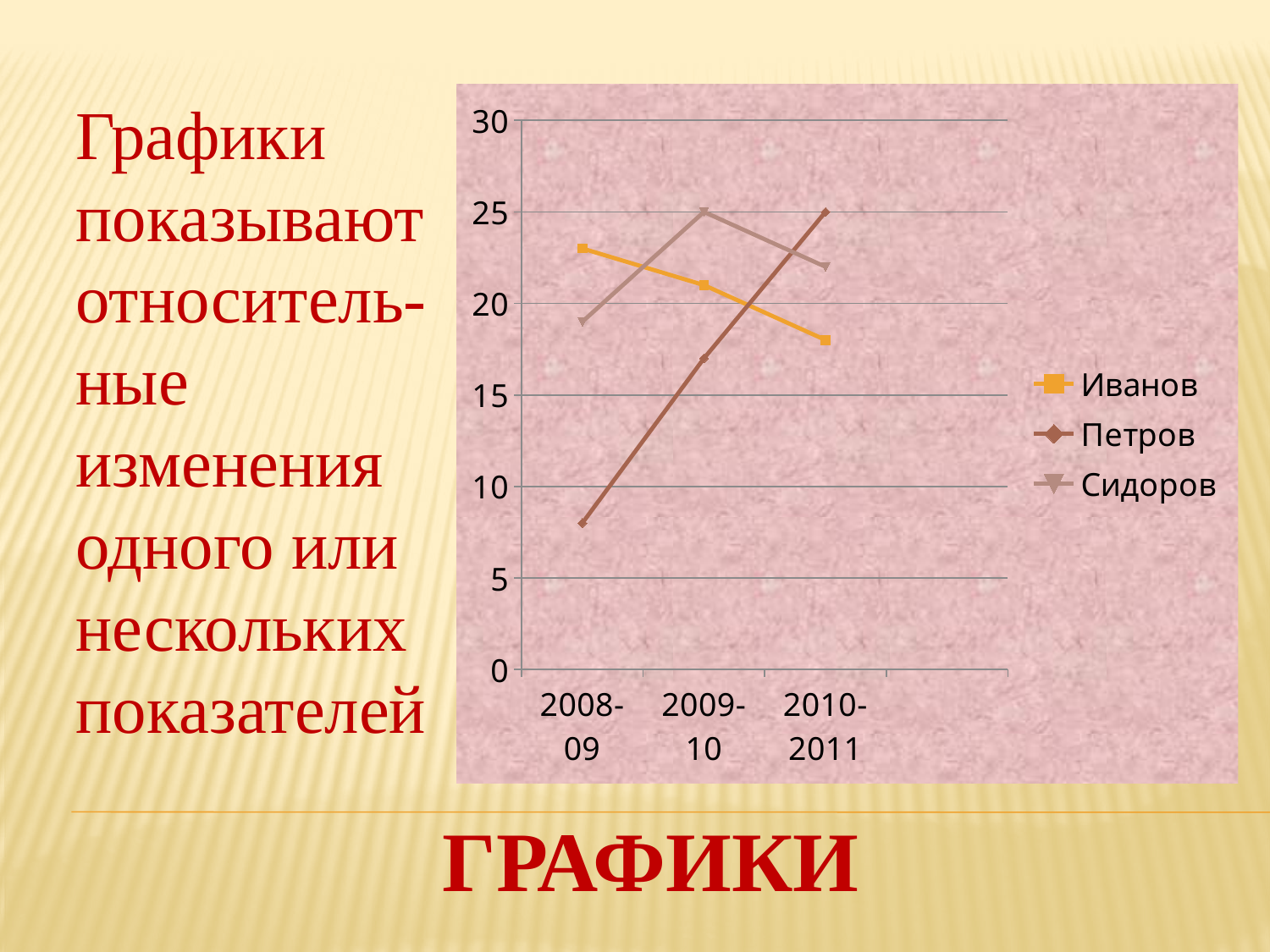
Do the values for Иванов rise or fall from 2008-09 to 2010-2011? fall Is the value for Иванов in 2010-2011 greater or less than 20? less How many series does the legend list? 3 Is the value for Петров in 2008-09 greater or less than 10? less What kind of chart is shown on the slide? line chart How many periods are shown on the x axis? 3 What is the value for Петров in 2010-2011? 25 What is the value for Сидоров in 2009-10? 25 Is the value for Иванов in 2008-09 greater or less than 20? greater Do the values for Петров rise or fall from 2008-09 to 2010-2011? rise Which series has the lowest value in 2008-09? Петров Which is larger in 2010-2011, the value for Петров or the value for Иванов? Петров